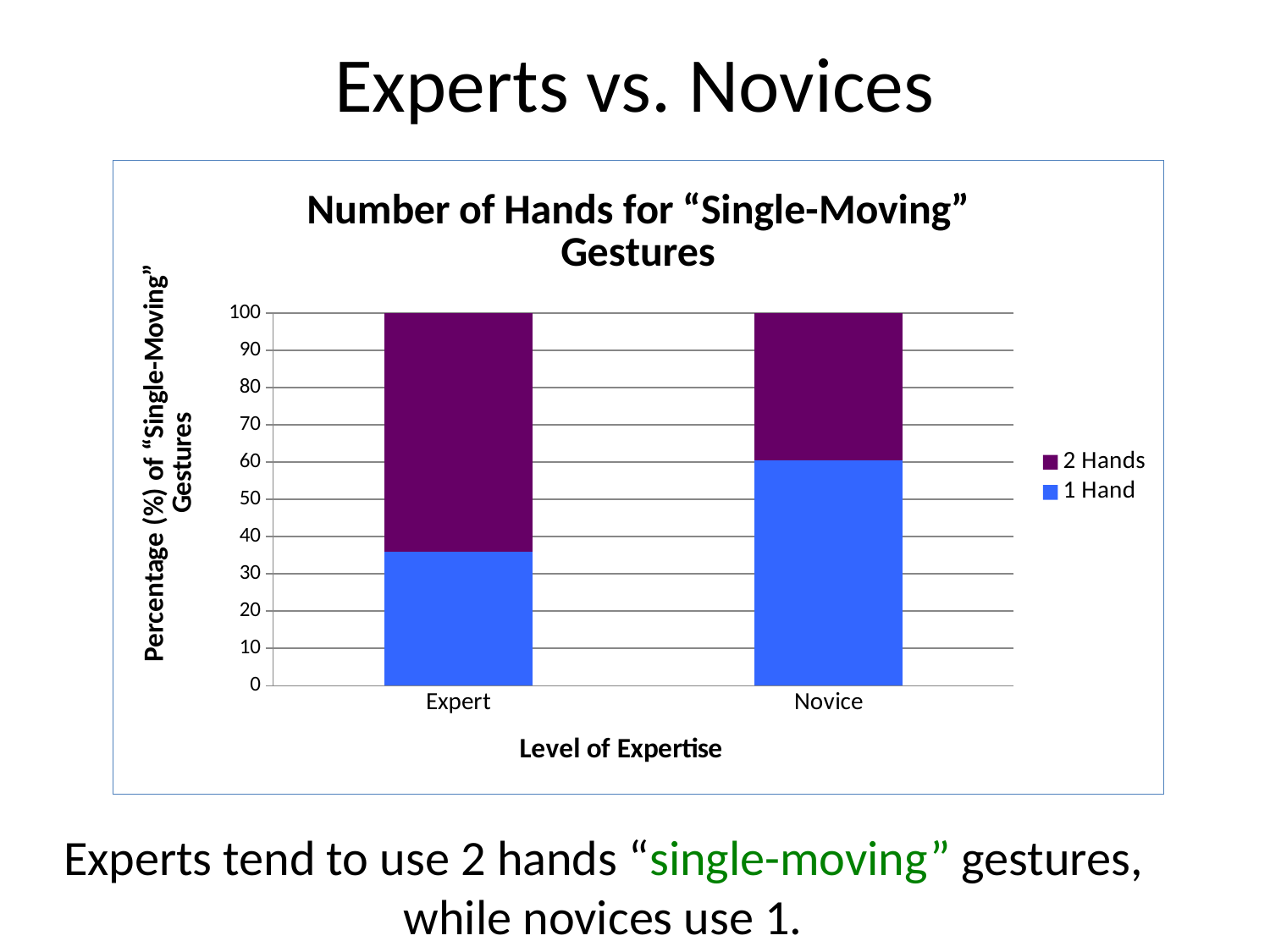
Is the 1 Hand value for Novice greater or less than 50? greater What is the total height of the stacked bar for Novice? 100 How many categories are shown on the x axis? 2 What kind of chart is shown on the slide? Stacked bar chart How many series does the legend list? 2 Is the 1 Hand value for Expert greater or less than 30? greater Is the 1 Hand value for Expert greater or less than 40? less Which category has the larger 1 Hand value, Expert or Novice? Novice What is the total height of the stacked bar for Expert? 100 Which category has the larger 2 Hands share, Expert or Novice? Expert What is the title of the chart? Number of Hands for "Single-Moving" Gestures What is the label of the x axis? Level of Expertise